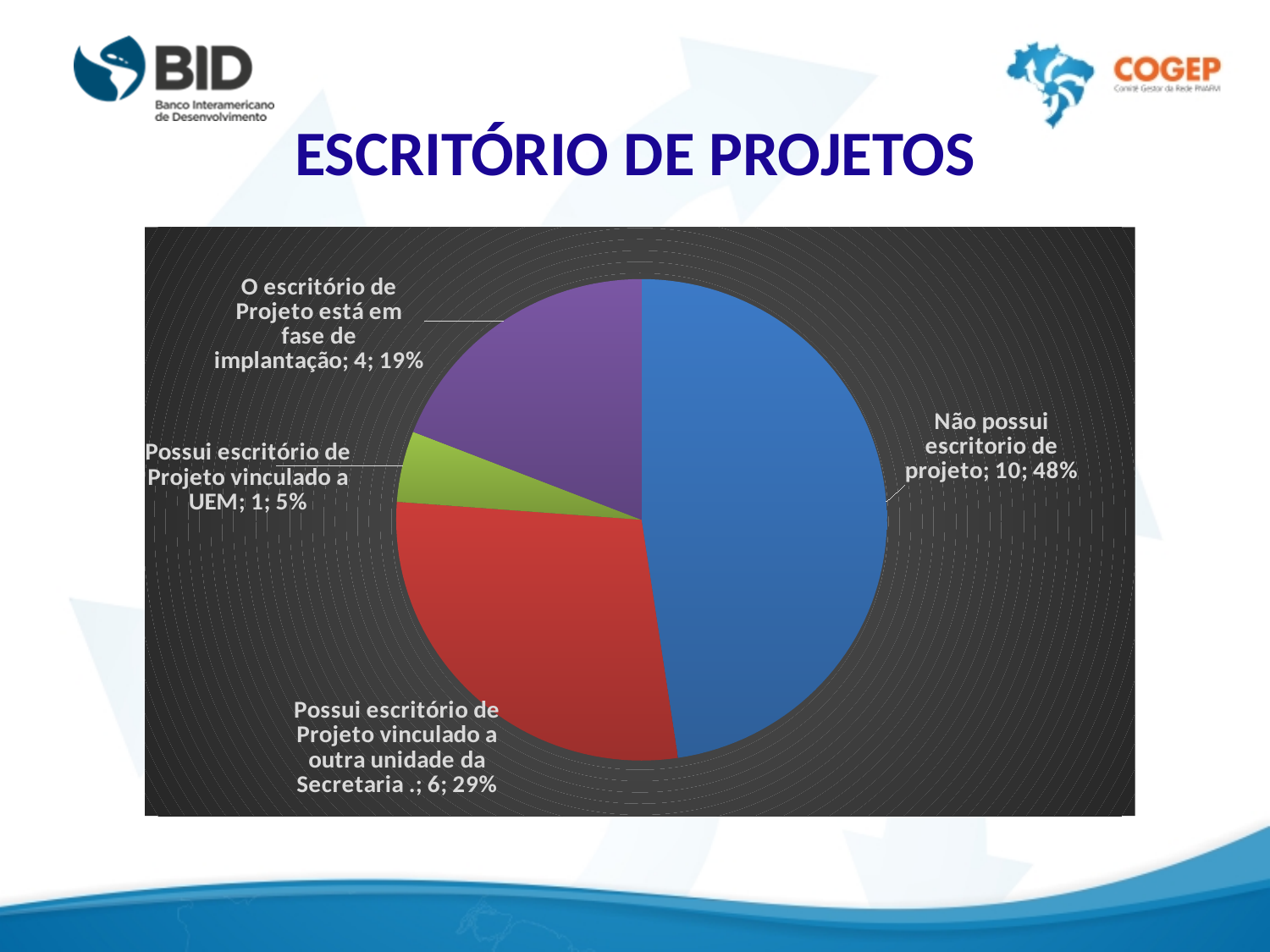
How many slices does the pie chart have? 4 What is the count for 'O escritório de Projeto está em fase de implantação'? 4 What is the title of the slide containing the chart? ESCRITÓRIO DE PROJETOS Which category has the smallest slice? Possui escritório de Projeto vinculado a UEM What percentage share does 'Não possui escritorio de projeto' have? 48% What is the count for 'Não possui escritorio de projeto'? 10 What percentage share does 'Possui escritório de Projeto vinculado a UEM' have? 5% Which is larger: the count for 'O escritório de Projeto está em fase de implantação' or for 'Possui escritório de Projeto vinculado a UEM'? O escritório de Projeto está em fase de implantação What is the count for 'Possui escritório de Projeto vinculado a outra unidade da Secretaria'? 6 Which category has the largest slice? Não possui escritorio de projeto What kind of chart is shown on the slide? pie chart What is the difference in count between 'Não possui escritorio de projeto' and 'Possui escritório de Projeto vinculado a outra unidade da Secretaria'? 4